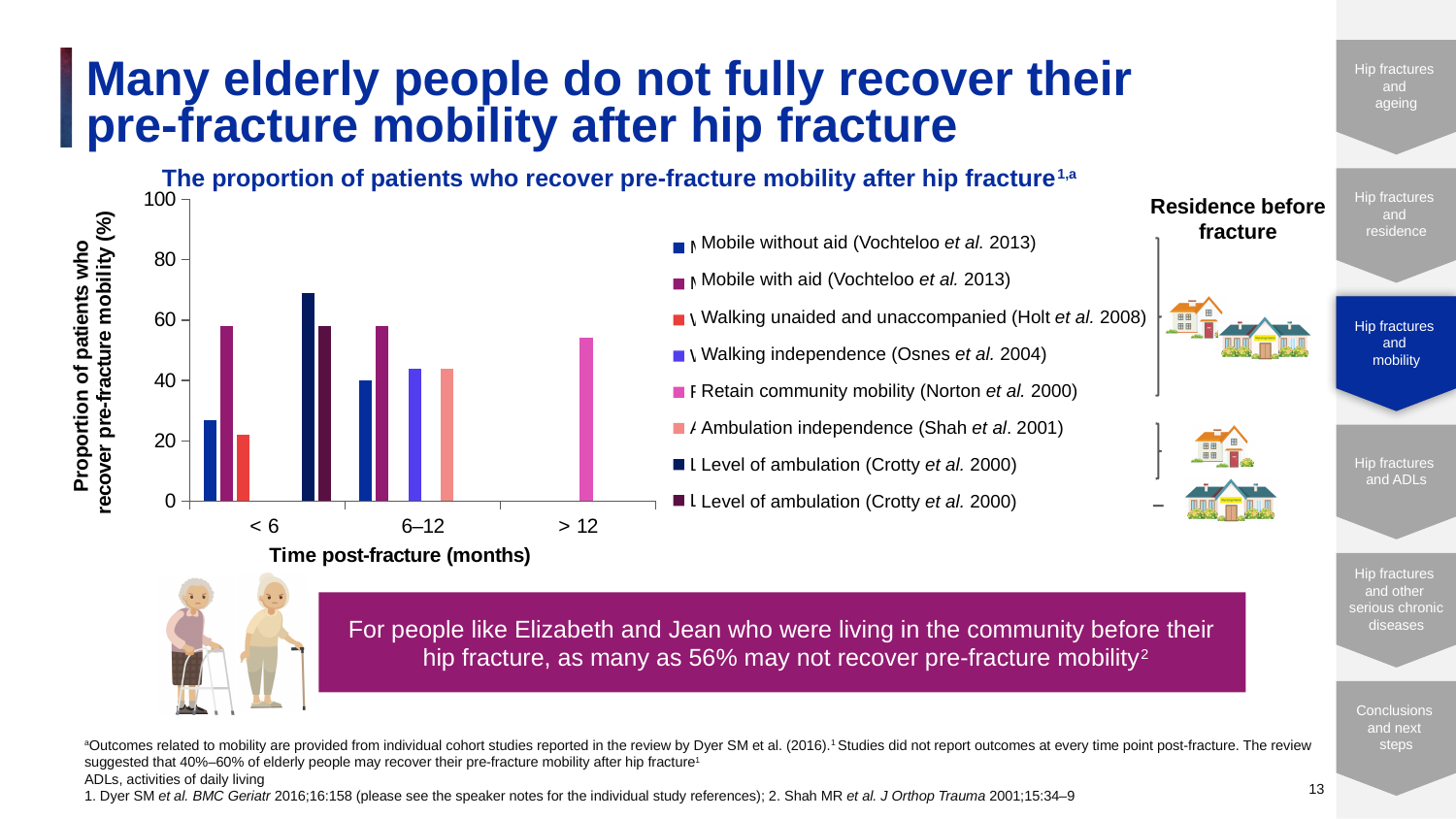
Is the value for Walking independence (Osnes et al. 2004) at 6–12 months greater or less than 60? less Is the value for Mobile without aid (Vochteloo et al. 2013) at < 6 months greater or less than 40? less How many series does the chart legend list? 8 Is the value for Mobile with aid (Vochteloo et al. 2013) at < 6 months greater or less than 40? greater How many time post-fracture categories are shown on the x axis? 3 What is the title of the y axis? Proportion of patients who recover pre-fracture mobility (%) At < 6 months, which is larger: Mobile with aid (Vochteloo et al. 2013) or Mobile without aid (Vochteloo et al. 2013)? Mobile with aid (Vochteloo et al. 2013) What kind of chart is shown on the slide? Bar chart What is the title of the x axis? Time post-fracture (months)